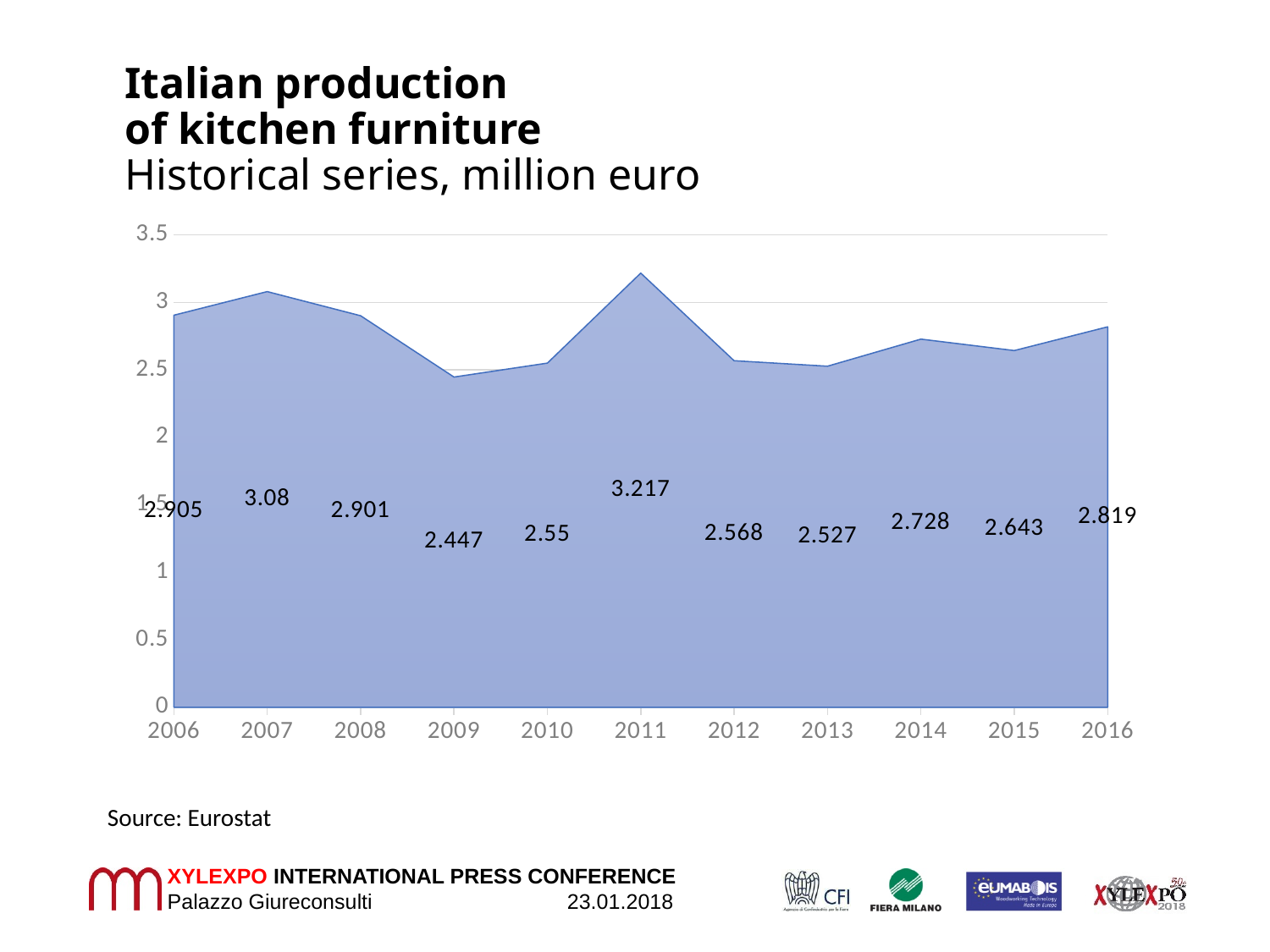
Which year has the lowest value? 2009 What is the value for 2009? 2.447 What kind of chart is shown on the slide? area chart What is the value for 2011? 3.217 Which year has the highest value? 2011 Do the values rise or fall from 2013 to 2014? rise What is the difference between the values for 2011 and 2009? 0.77 What is the value for 2016? 2.819 Which is larger, the value for 2007 or the value for 2008? 2007 What is the difference between the values for 2016 and 2015? 0.176 Is the value for 2014 greater or less than 3? less How many years are plotted on the chart? 11